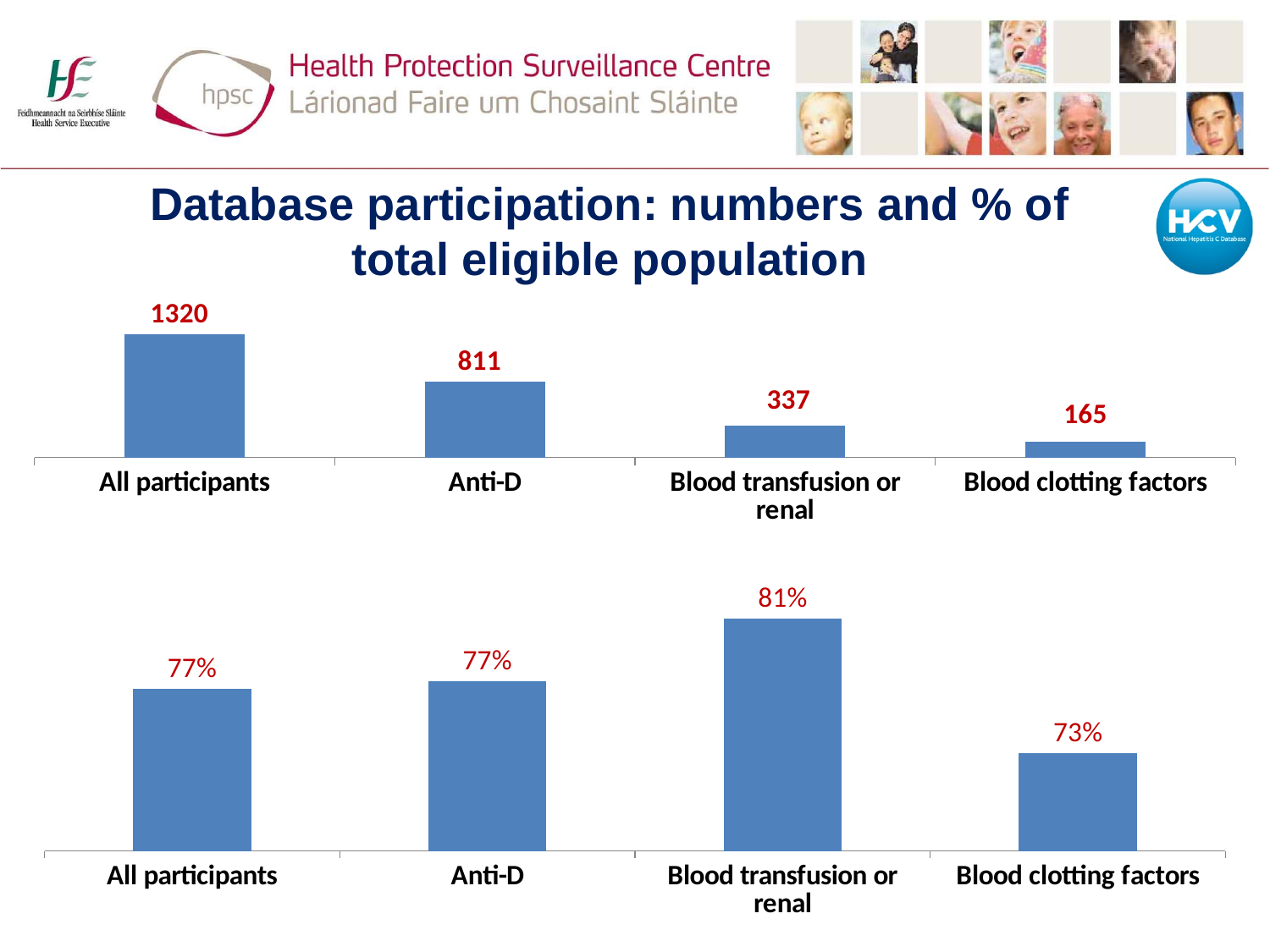
In the bottom chart, which category has the highest value? Blood transfusion or renal In the top chart, which category has the lowest value? Blood clotting factors In the top chart, what is the value for Blood clotting factors? 165 In the bottom chart, what is the value for Blood clotting factors? 73% In the bottom chart, what is the value for Blood transfusion or renal? 81% What is the title of the slide containing the two charts? Database participation: numbers and % of total eligible population In the top chart, which is larger: the value for Blood transfusion or renal or the value for Blood clotting factors? Blood transfusion or renal What type of chart is the bottom chart? Bar chart In the top chart, what is the value for Anti-D? 811 How many categories are shown in the top chart? 4 In the top chart, what is the difference between the values for Anti-D and Blood transfusion or renal? 474 In the bottom chart, what is the difference between the values for Blood transfusion or renal and Blood clotting factors? 8%